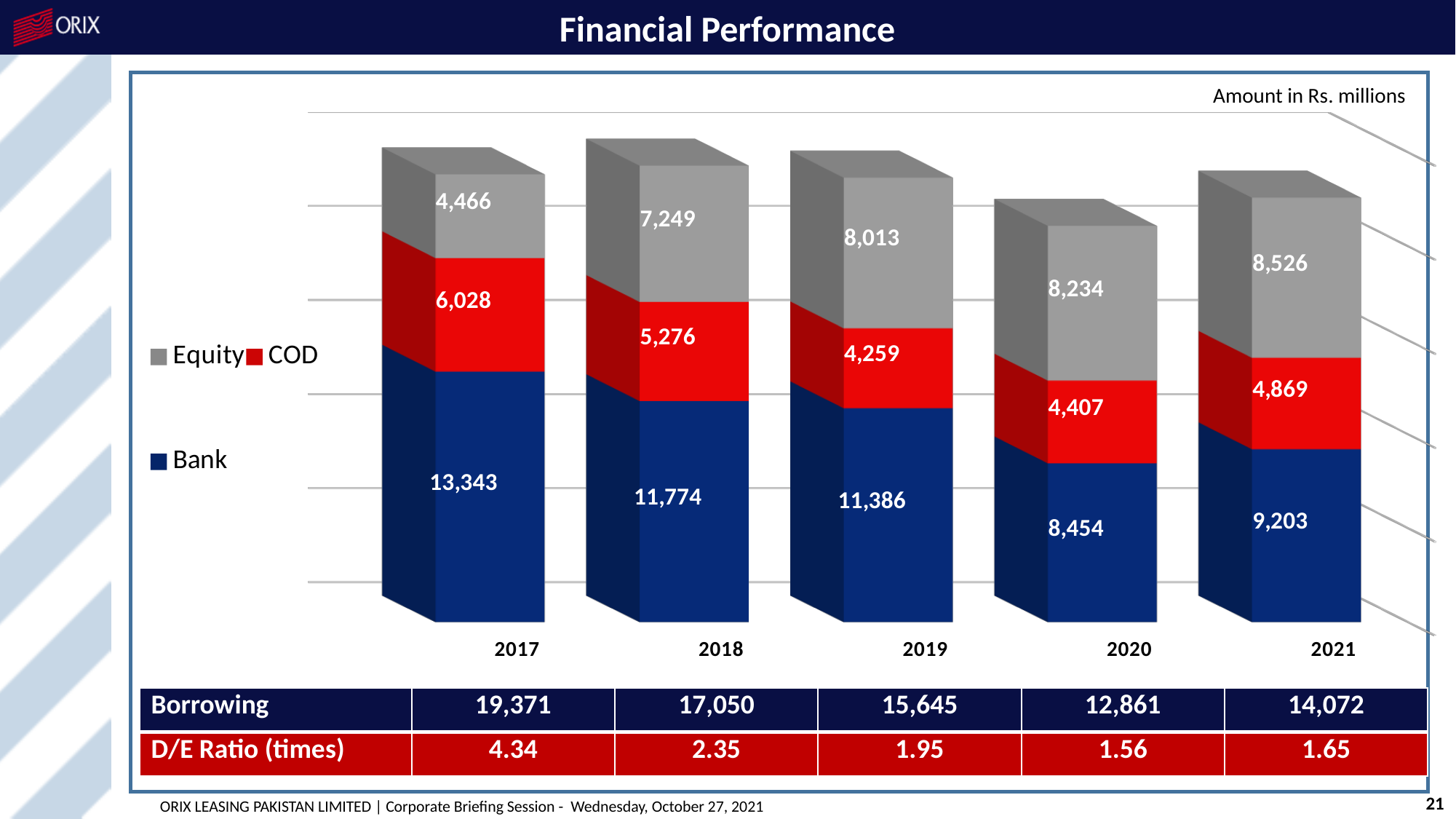
Which year has the lowest COD value? 2019 How many series does the chart legend list? 3 What is the difference between the Bank value in 2017 and the Bank value in 2021? 4,140 What is the total of the stacked bar for 2020? 21,095 What is the Bank value for 2017? 13,343 Is the Equity value larger in 2018 or in 2017? 2018 Does the Equity value rise or fall from 2017 to 2021? rise Which year has the lowest Bank value? 2020 Which year has the highest Bank value? 2017 What is the Equity value for 2021? 8,526 What is the COD value for 2019? 4,259 How many years are shown on the x axis of the chart? 5